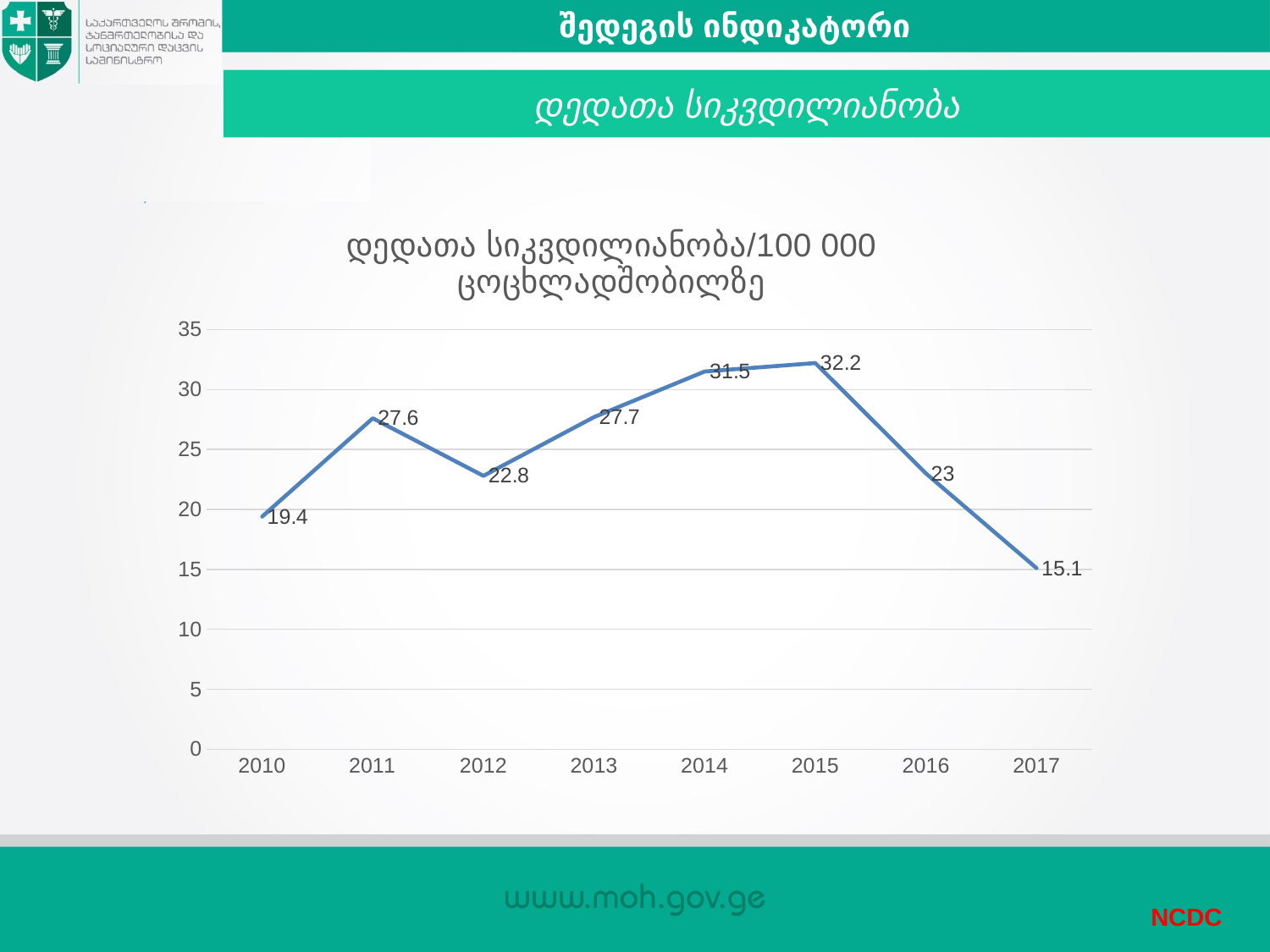
Which is larger, the value for 2011 or the value for 2013? 2013 What kind of chart is shown? line chart What is the value for 2015? 32.2 Which year has the highest value? 2015 Do the values rise or fall from 2015 to 2017? fall What is the difference between the values for 2012 and 2013? 4.9 Which year has the lowest value? 2017 Is the value for 2016 greater or less than 25? less What is the value for 2010? 19.4 How many years are plotted on the x axis? 8 What is the value for 2017? 15.1 What is the difference between the values for 2015 and 2017? 17.1